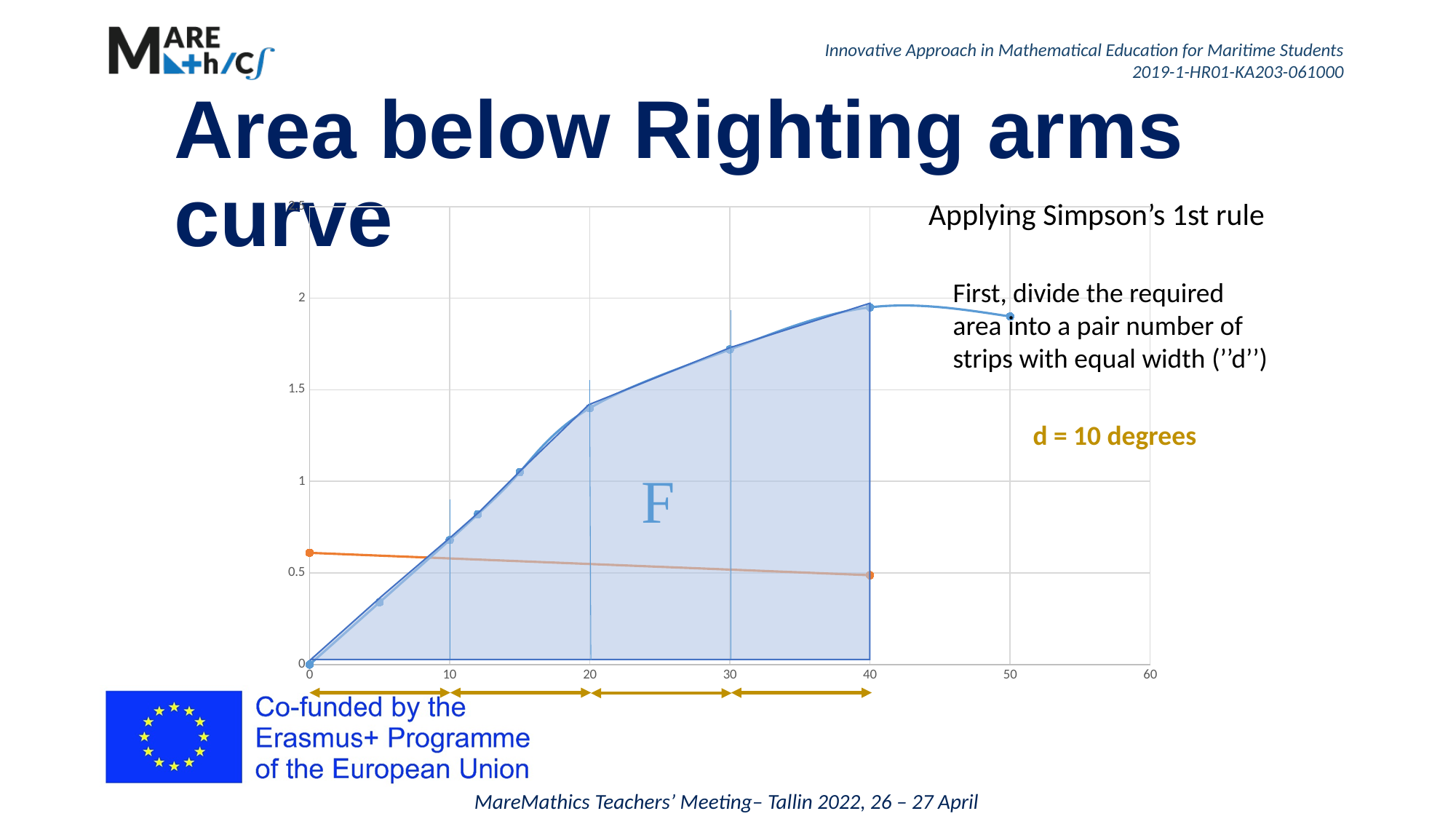
Among the x values 0, 10, 20, 30 and 40, at which one is the blue curve highest? 40 Among the x values 0, 10, 20, 30 and 40, at which one is the blue curve lowest? 0 What letter labels the shaded area under the curve? F Is the value of the blue curve at x = 20 greater or less than 1? greater Does the orange line rise or fall as the x axis goes from 0 to 40? fall What kind of chart is shown on the slide? line chart Is the value of the orange line at x = 0 greater or less than 1? less Does the blue righting arm curve rise or fall as the x axis goes from 0 to 40? rise What is the largest value shown on the x axis? 60 At x = 20, which line has the larger value, the blue curve or the orange line? the blue curve Is the value of the blue curve at x = 30 greater or less than 1.5? greater